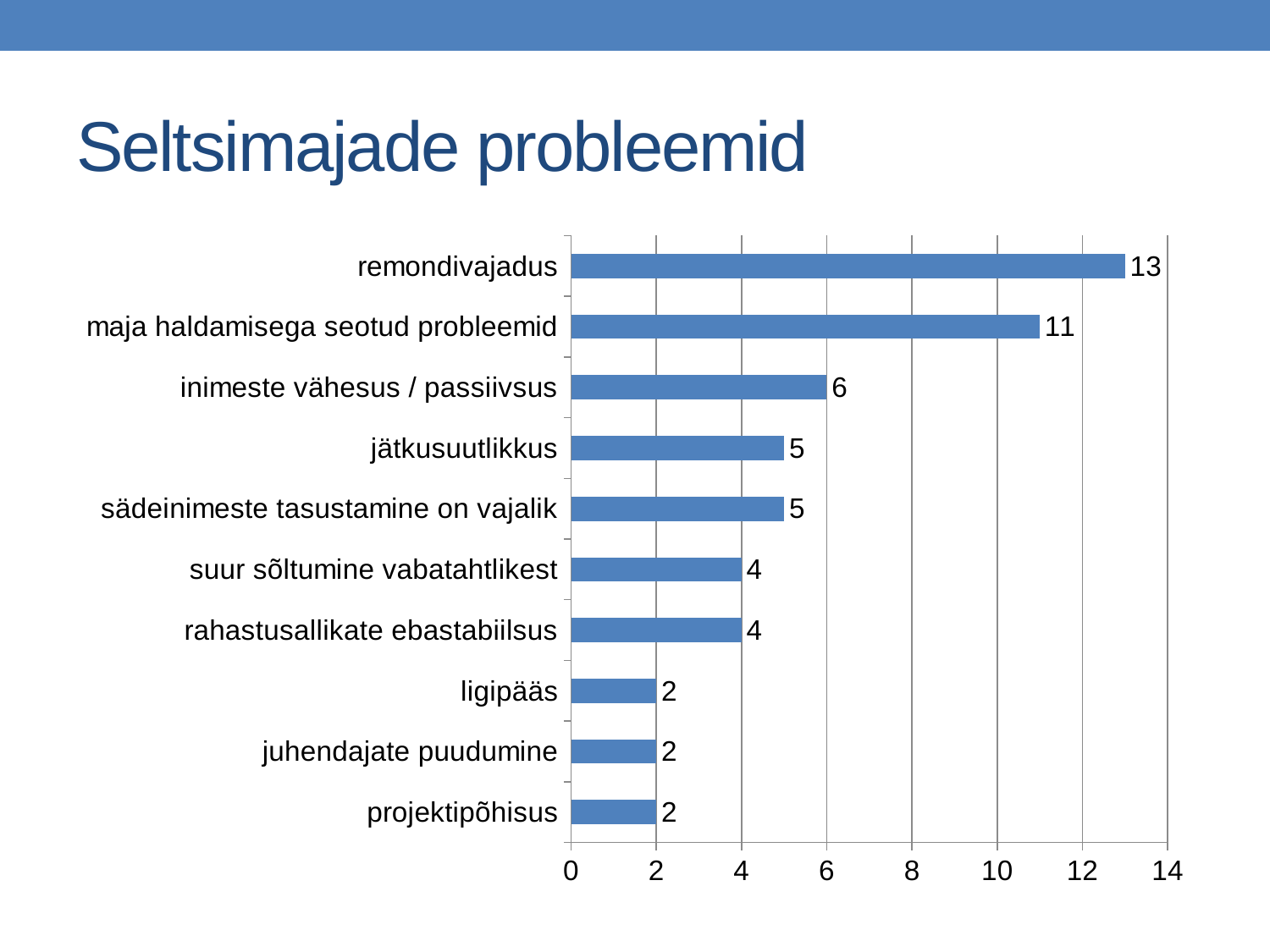
Which category has the highest value? remondivajadus Which is larger, the value for jätkusuutlikkus or the value for rahastusallikate ebastabiilsus? jätkusuutlikkus What is the difference between the values for inimeste vähesus / passiivsus and ligipääs? 4 What is the value for maja haldamisega seotud probleemid? 11 What is the value for remondivajadus? 13 How many categories are shown in the chart? 10 What is the title of the slide? Seltsimajade probleemid What is the value for inimeste vähesus / passiivsus? 6 What kind of chart is shown on the slide? bar chart What is the difference between the values for remondivajadus and maja haldamisega seotud probleemid? 2 Is the value for maja haldamisega seotud probleemid greater or less than 10? greater What is the value for suur sõltumine vabatahtlikest? 4